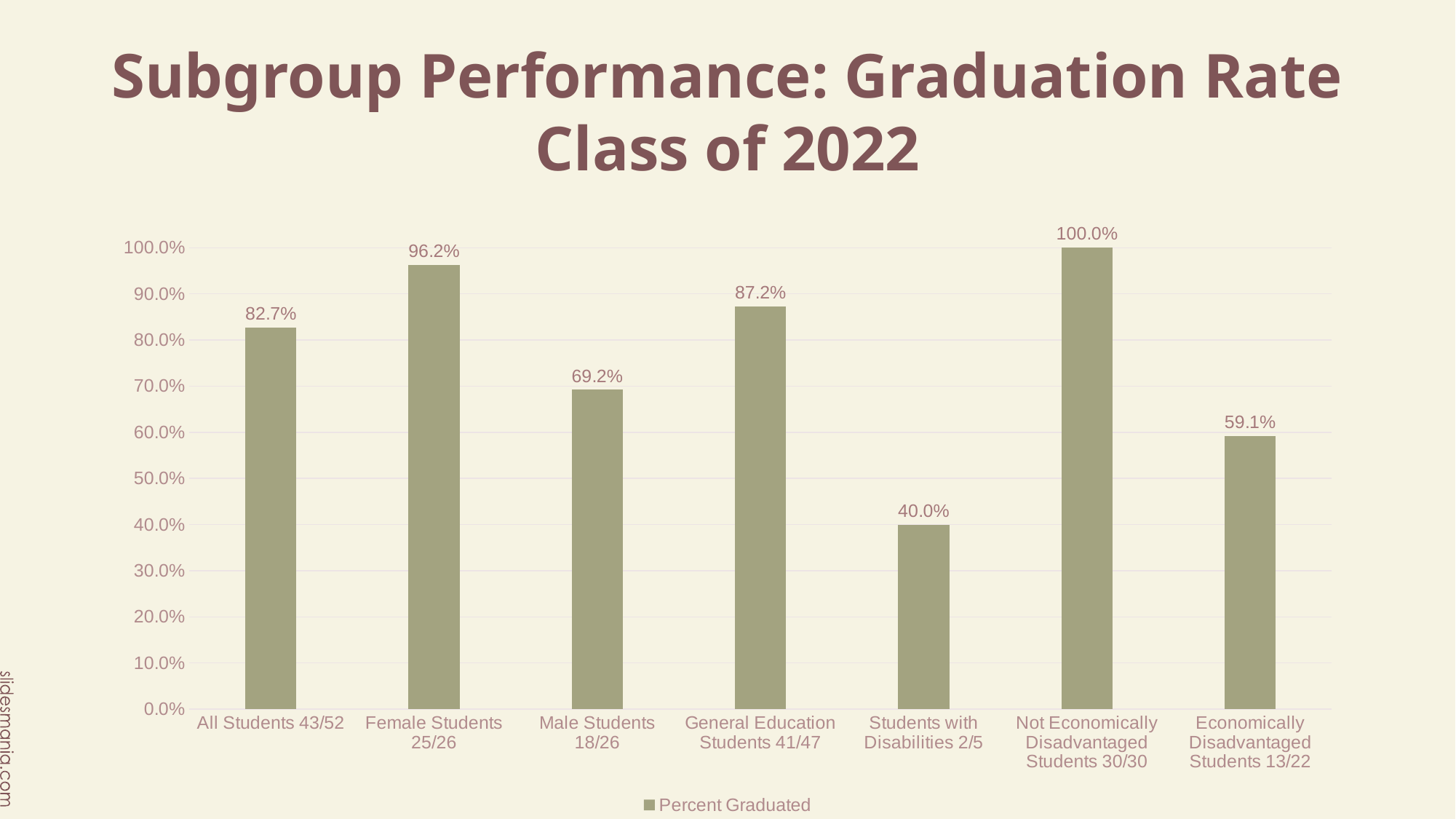
What is the graduation rate for Economically Disadvantaged Students 13/22? 59.1% What is the graduation rate for Female Students 25/26? 96.2% Is the graduation rate for Male Students 18/26 greater or less than 80.0%? less Which has a higher graduation rate, General Education Students 41/47 or All Students 43/52? General Education Students 41/47 What is the name of the series shown in the legend? Percent Graduated What kind of chart is shown on the slide? bar chart Which subgroup has the lowest graduation rate? Students with Disabilities 2/5 How many subgroups are shown on the chart? 7 What is the difference between the graduation rates of Female Students 25/26 and Male Students 18/26? 27.0% How many series does the legend list? 1 Which subgroup has the highest graduation rate? Not Economically Disadvantaged Students 30/30 What is the graduation rate for Students with Disabilities 2/5? 40.0%